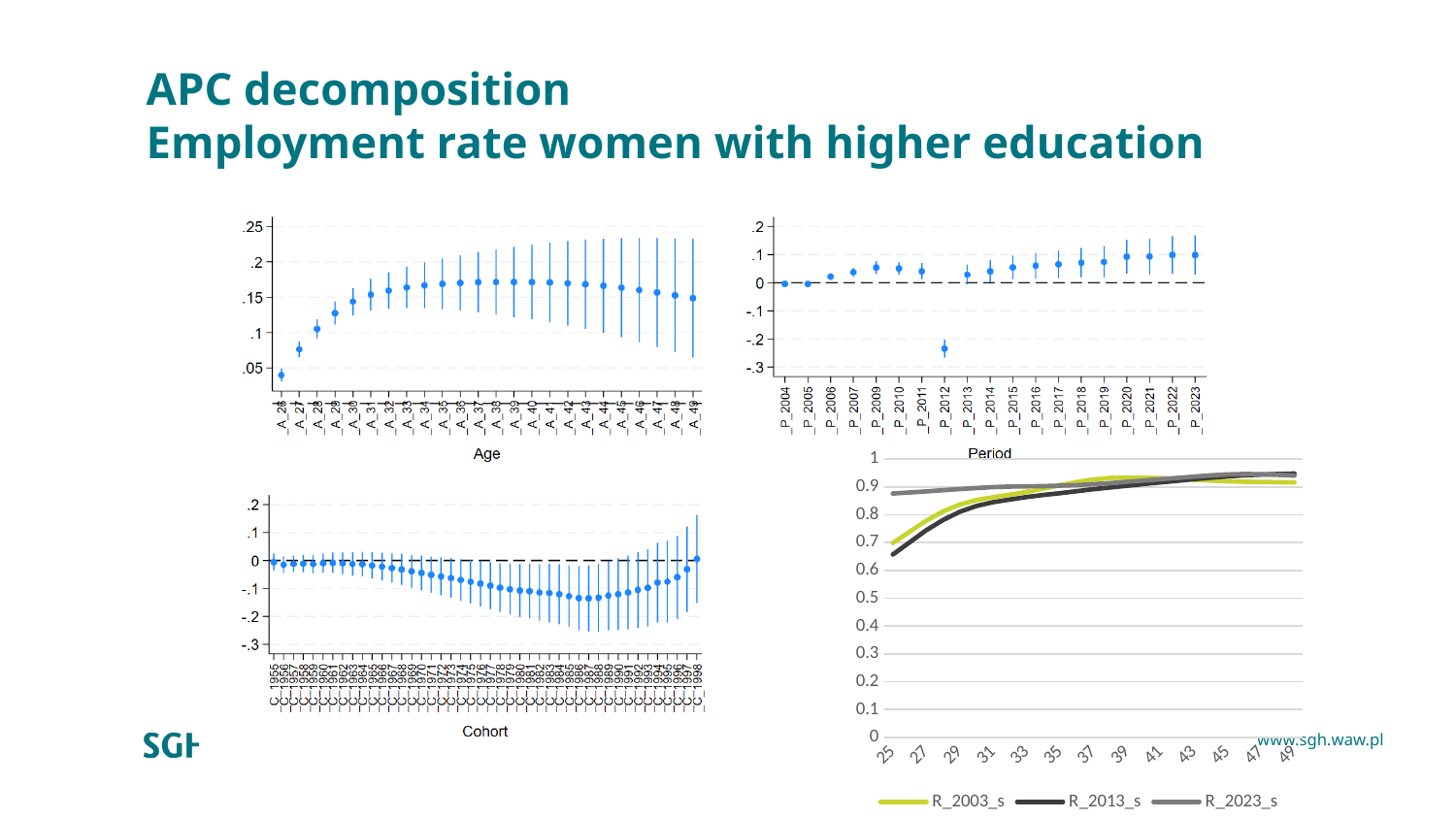
In the bottom-right chart, do the values of R_2013_s rise or fall from 25 to 49? rise What kind of chart is the bottom-right chart with the legend R_2003_s, R_2013_s, R_2023_s? line chart In the bottom-right chart, which series has the lowest value at 25? R_2013_s In the bottom-right chart, is the value of R_2013_s at 25 greater or less than 0.7? less In the Cohort chart (bottom left), is the estimate for C_1986 greater or less than -.1? less In the Period chart (top right), which period has the lowest estimate? P_2012 In the Period chart (top right), is the estimate for P_2012 greater or less than -.1? less In the Age chart (top left), which age has the lowest estimate? A_26 In the Age chart (top left), do the estimates rise or fall from A_26 to A_34? rise How many periods are plotted on the x axis of the Period chart (top right)? 19 How many series does the legend of the bottom-right chart list? 3